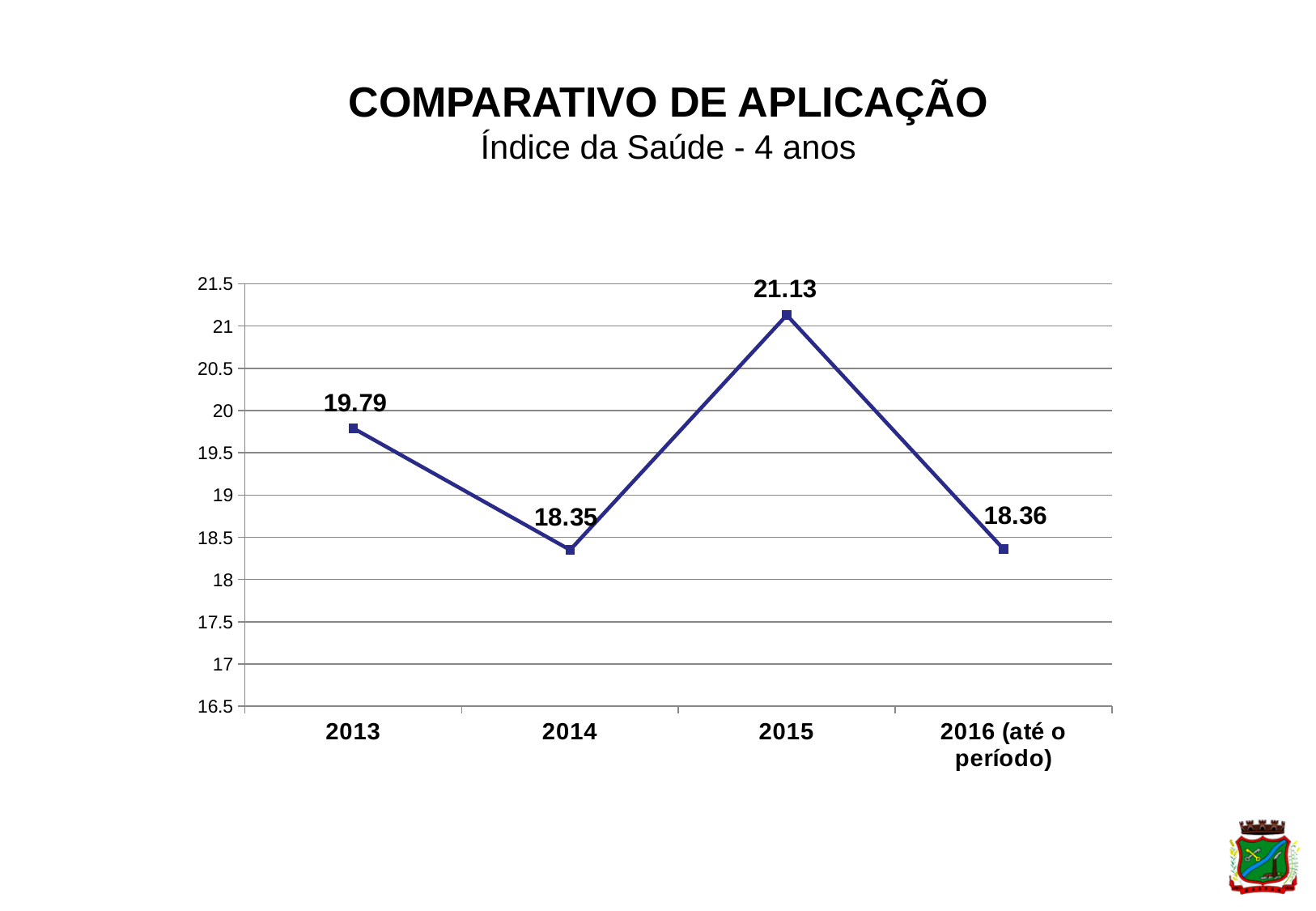
What kind of chart is shown on the slide? line chart Which is larger, the value for 2013 or the value for 2015? 2015 What is the value for 2013? 19.79 What is the value for 2015? 21.13 What is the subtitle of the chart? Índice da Saúde - 4 anos Which year has the highest value? 2015 What is the value for 2016 (até o período)? 18.36 What is the difference between the values for 2015 and 2014? 2.78 What is the value for 2014? 18.35 What is the difference between the values for 2013 and 2014? 1.44 Is the value for 2015 greater or less than 21? greater How many data points are plotted on the chart? 4